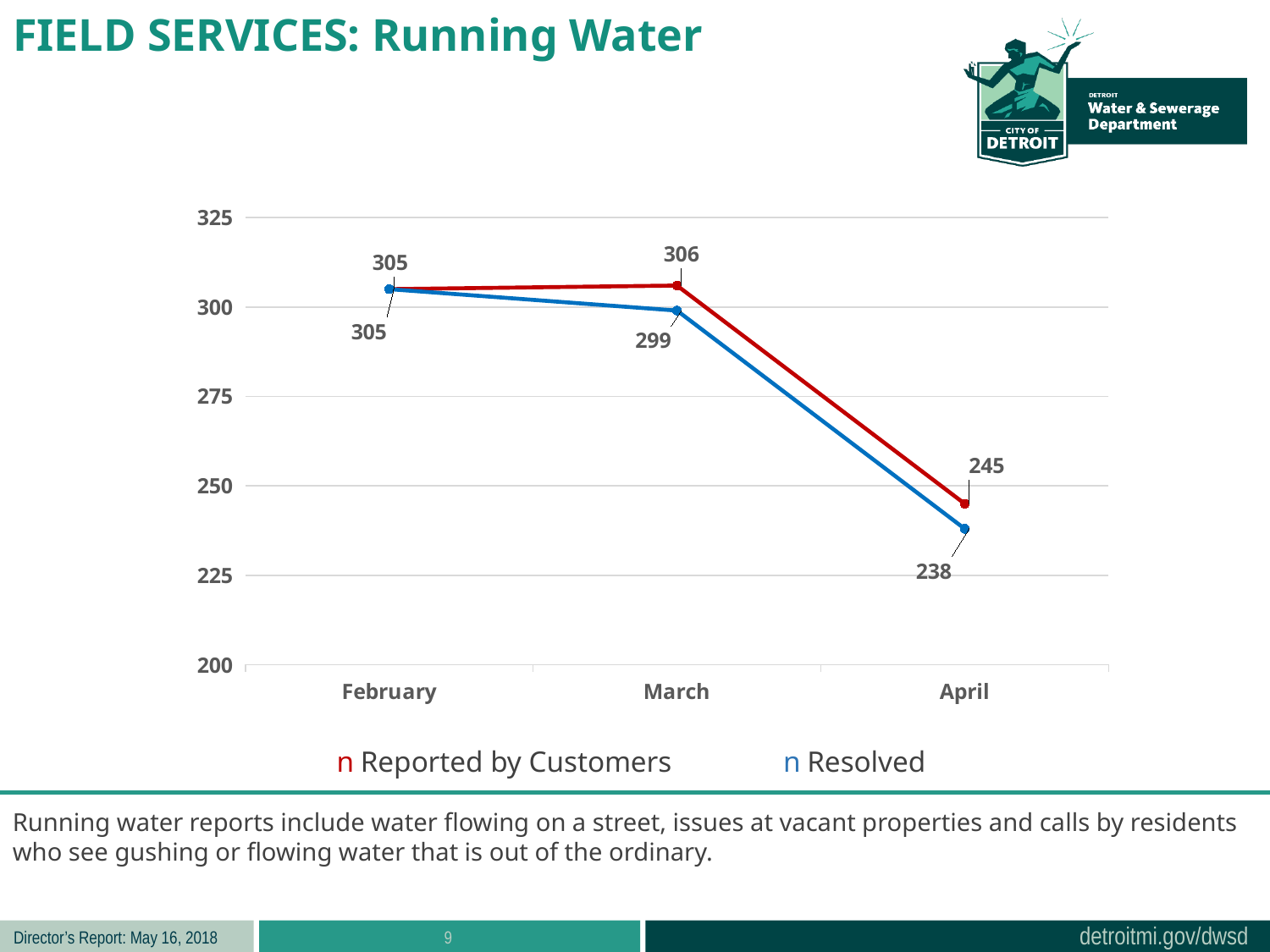
How many series does the legend list? 2 What type of chart is shown on the slide? line chart In which month is the Reported by Customers value lowest? April What is the value for Resolved in April? 238 In which month is the Reported by Customers value highest? March Which colour is used for the Resolved series? blue What is the value for Reported by Customers in March? 306 Does the Resolved series rise or fall from February to April? fall Which is larger in March, Reported by Customers or Resolved? Reported by Customers How many months are plotted on the x axis? 3 What is the difference between Reported by Customers and Resolved in April? 7 What is the value for Resolved in March? 299